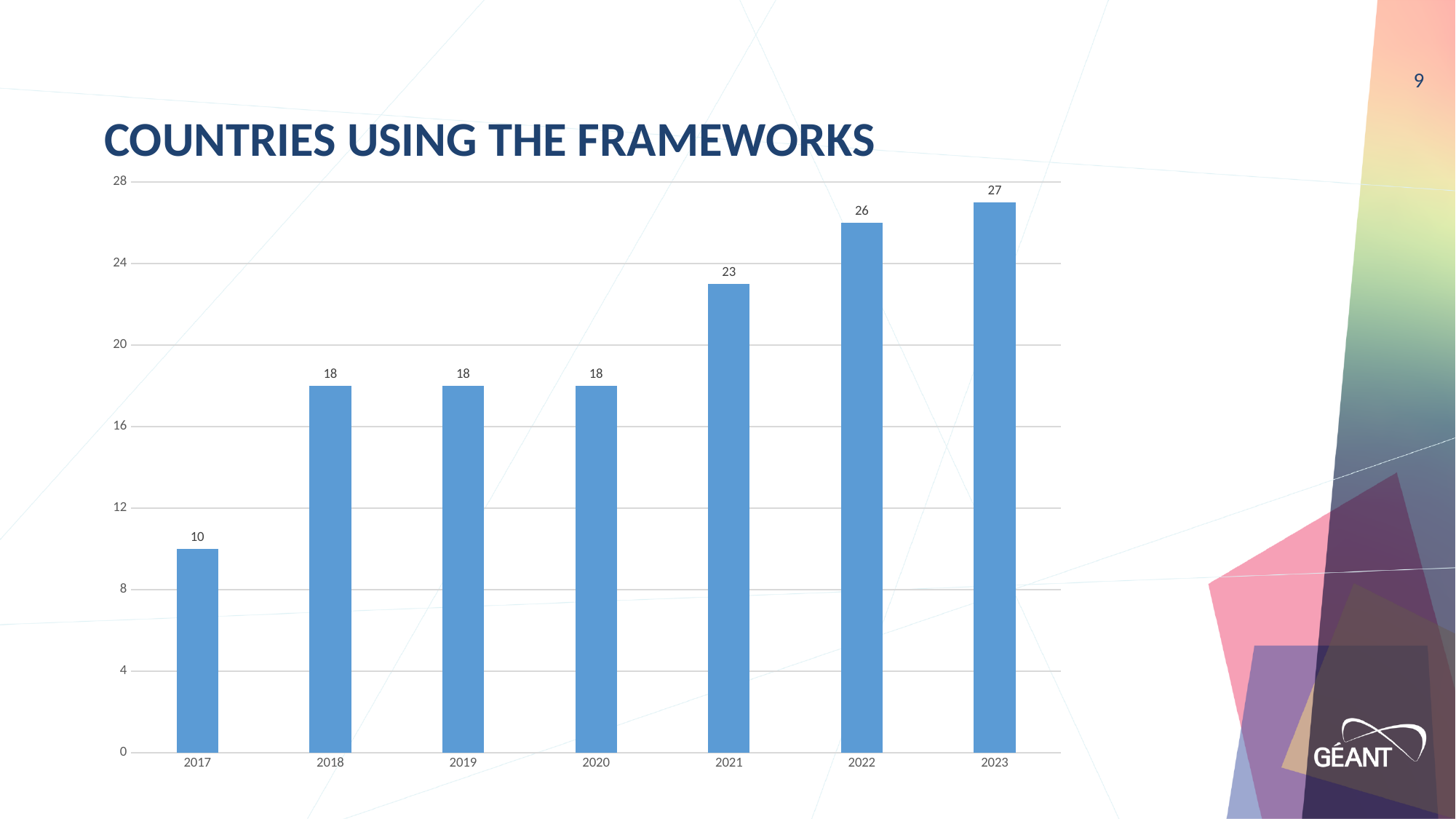
Do the values generally rise or fall from 2017 to 2023? rise What is the value for 2023? 27 Is the value for 2022 greater or less than 24? greater Which year has the highest value? 2023 Which is larger, the value for 2020 or the value for 2021? 2021 What is the difference between the values for 2023 and 2017? 17 How many years are shown on the x axis? 7 What is the difference between the values for 2022 and 2021? 3 What kind of chart is shown on the slide? bar chart What is the value for 2017? 10 Which year has the lowest value? 2017 What is the value for 2021? 23